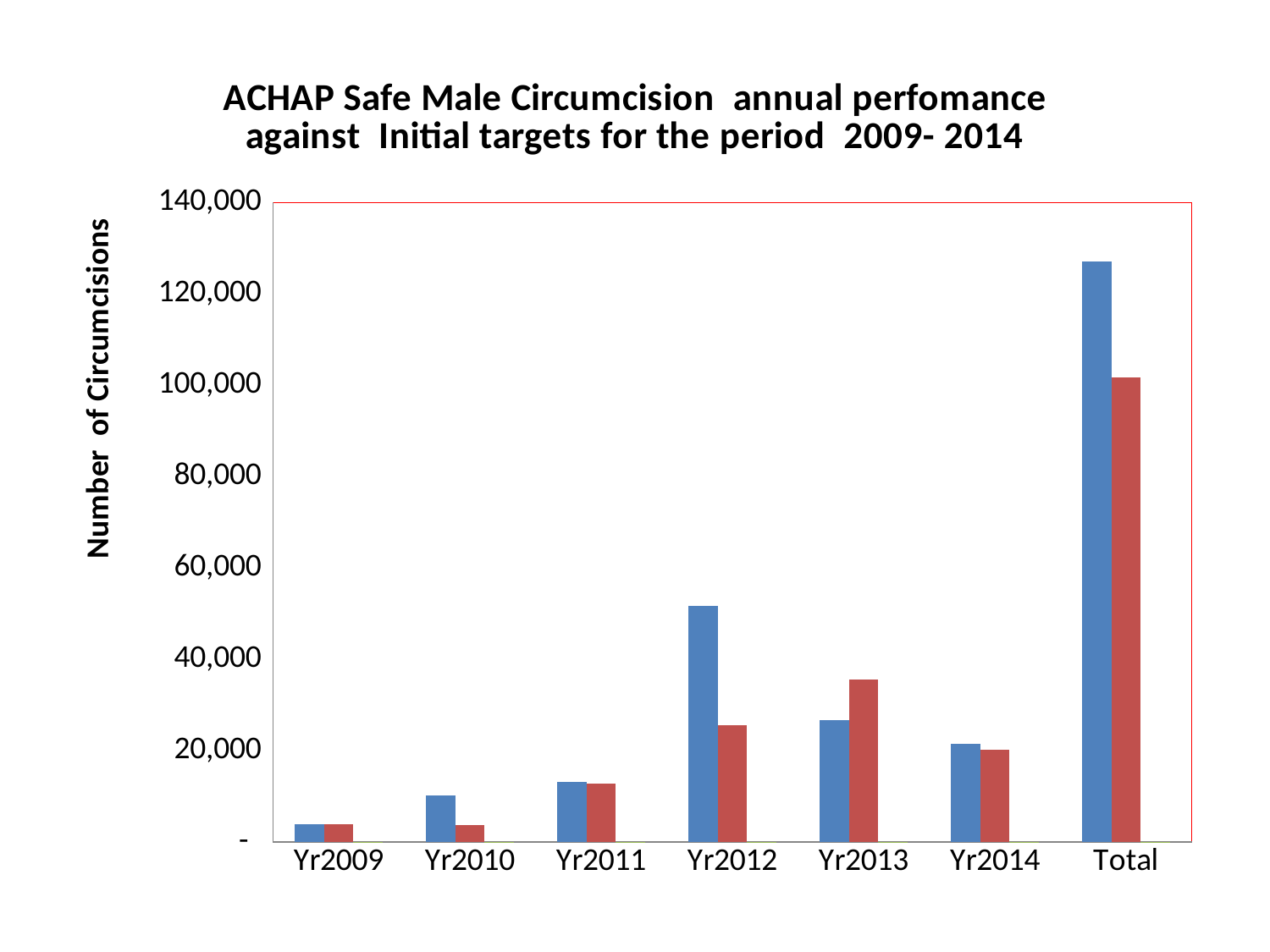
Is the red bar for Yr2013 greater or less than 40,000? less Is the blue bar for Yr2012 greater or less than 40,000? greater What kind of chart is shown on the slide? bar chart Which category has the tallest blue bar? Total Among the individual years Yr2009 to Yr2014, which year has the tallest blue bar? Yr2012 For Yr2012, which bar is taller, the blue bar or the red bar? the blue bar Is the blue bar for Total greater or less than 120,000? greater How many bars are plotted for each category on the x axis? 2 What is the label on the vertical axis of the chart? Number of Circumcisions How many categories are shown on the x axis? 7 Which category has the shortest blue bar? Yr2009 For Yr2013, which bar is taller, the blue bar or the red bar? the red bar